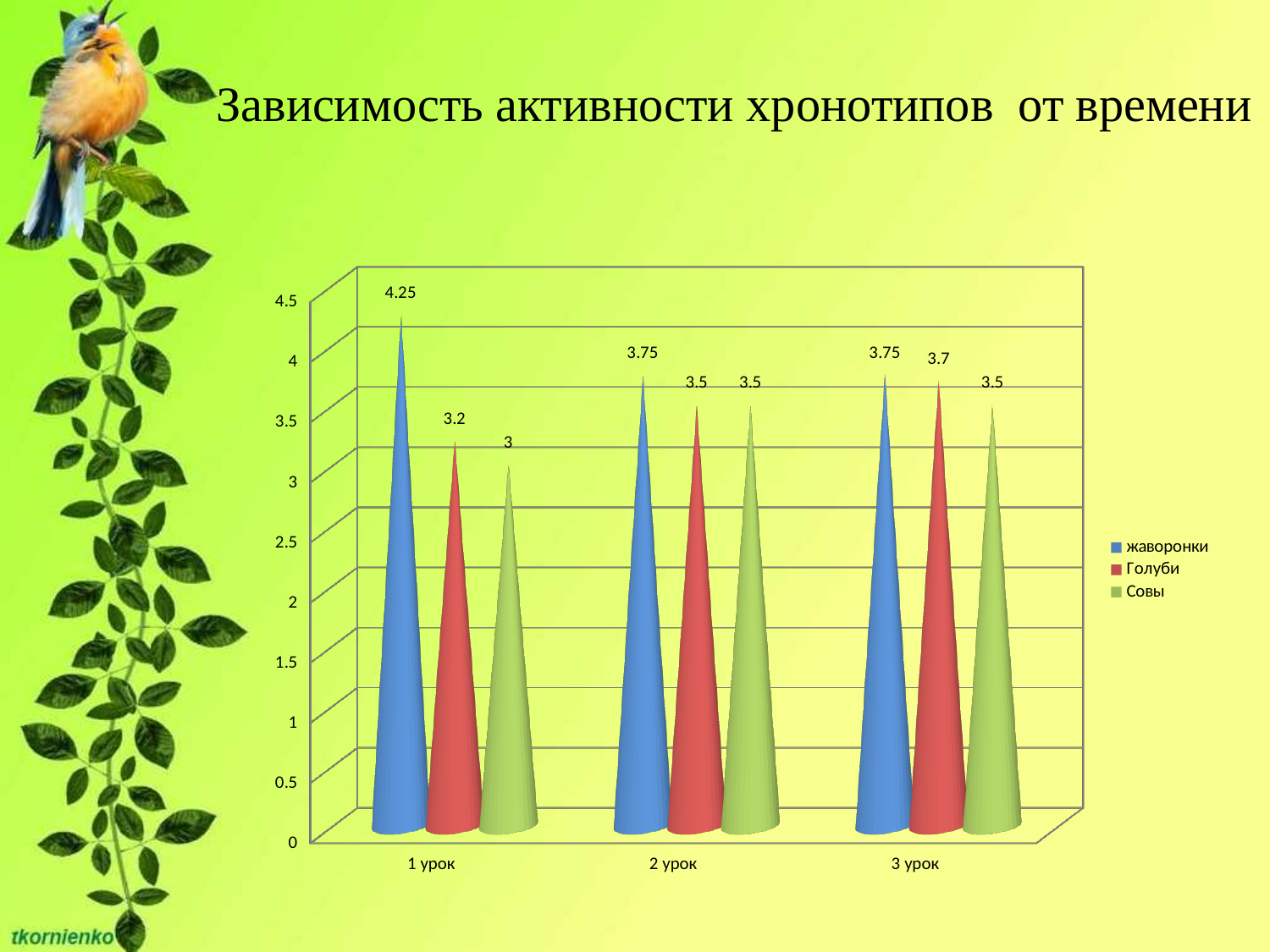
What is the value for Голуби at 3 урок? 3.7 What is the difference between the жаворонки and Голуби values at 1 урок? 1.05 What is the value for Голуби at 2 урок? 3.5 What is the value for Совы at 1 урок? 3 What is the value for жаворонки at 1 урок? 4.25 What kind of chart is shown on the slide? bar chart At which category is the value for жаворонки highest? 1 урок How many categories are shown on the x axis? 3 What is the title of the chart on the slide? Зависимость активности хронотипов от времени How many series does the legend list? 3 At which category is the value for Совы lowest? 1 урок Which is larger at 1 урок: the value for Голуби or the value for Совы? Голуби